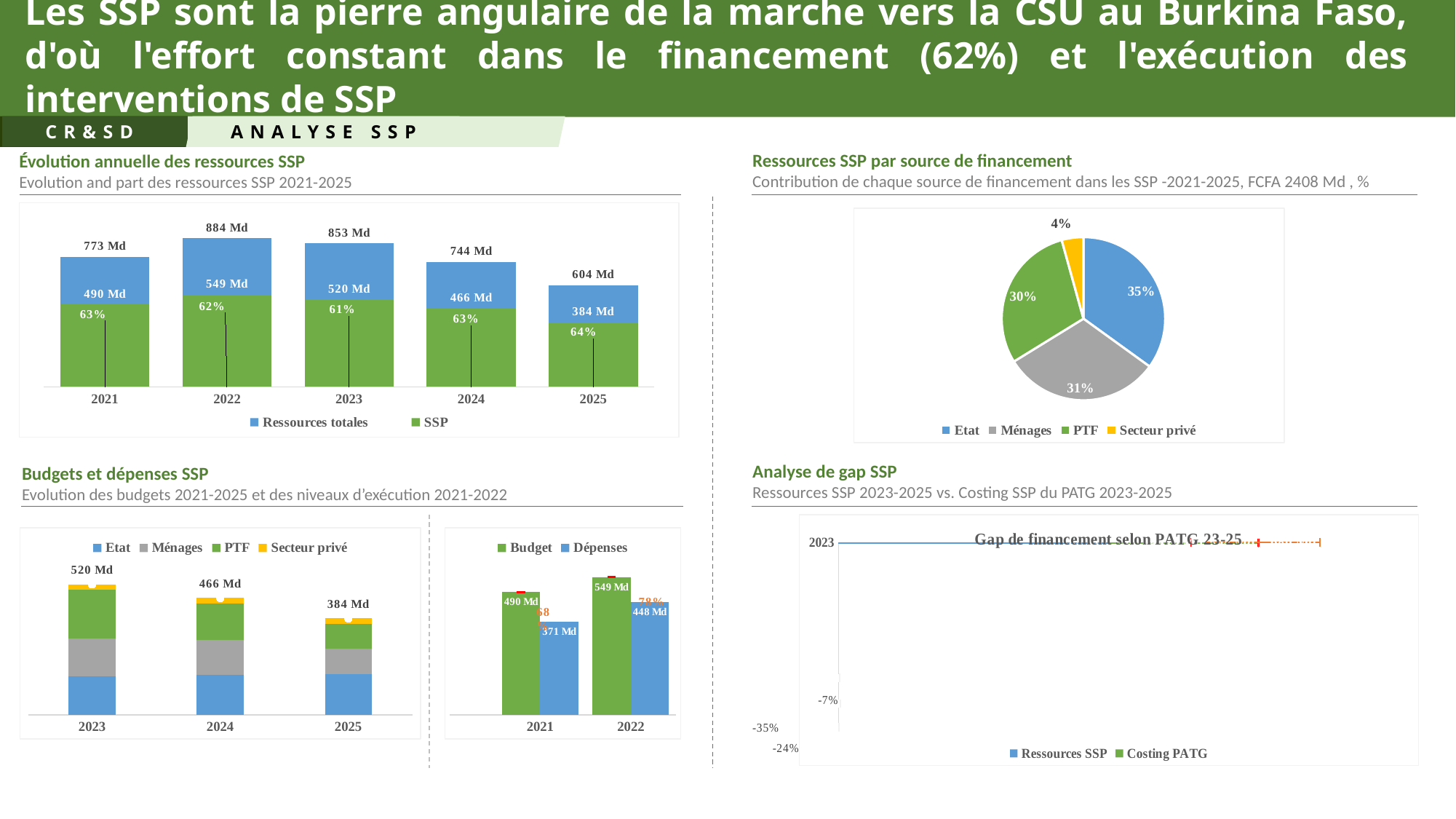
In the 'Ressources SSP par source de financement' pie chart, which source has the smallest share? Secteur privé In the 'Ressources SSP par source de financement' pie chart, what share does Etat have? 35% In the 'Évolution annuelle des ressources SSP' chart, what is the difference between Ressources totales and SSP in 2023? 333 Md In the 'Évolution annuelle des ressources SSP' chart, what is the SSP value for 2025? 384 Md In the 'Évolution annuelle des ressources SSP' chart, what percentage is shown for 2024? 63% In the 'Ressources SSP par source de financement' pie chart, how many slices are there? 4 In the 'Budgets et dépenses SSP' chart on the right (Budget vs Dépenses), what is the Dépenses value for 2022? 448 Md In the 'Évolution annuelle des ressources SSP' chart, which year has the lowest SSP value? 2025 In the 'Évolution annuelle des ressources SSP' chart, what is the value of Ressources totales for 2022? 884 Md In the 'Évolution annuelle des ressources SSP' chart, which year has the highest Ressources totales? 2022 In the 'Évolution annuelle des ressources SSP' chart, how many series does the legend list? 2 In the 'Budgets et dépenses SSP' chart on the right (Budget vs Dépenses), which is larger in 2021, Budget or Dépenses? Budget